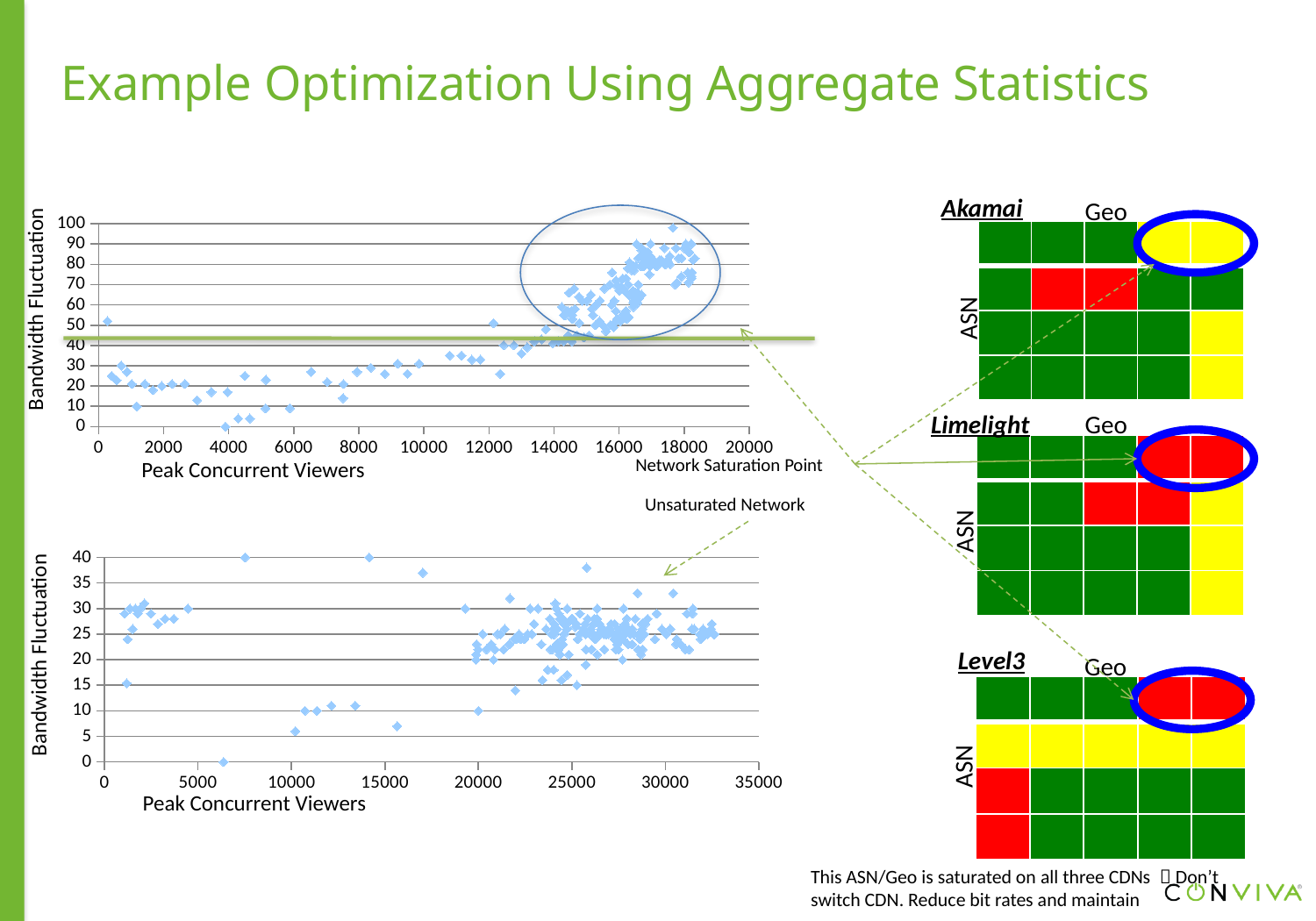
In the top chart, do the Bandwidth Fluctuation values generally rise or fall as Peak Concurrent Viewers increases? rise What is the x-axis label of the bottom chart? Peak Concurrent Viewers In the bottom chart, are the Bandwidth Fluctuation values for points between 20000 and 30000 Peak Concurrent Viewers greater or less than 5? greater In the top chart, what is the highest value shown on the Bandwidth Fluctuation axis? 100 In the top chart, are the Bandwidth Fluctuation values for points above 16000 Peak Concurrent Viewers greater or less than 50? greater What kind of chart is the bottom chart on the slide? scatter chart What kind of chart is the top chart on the slide? scatter chart